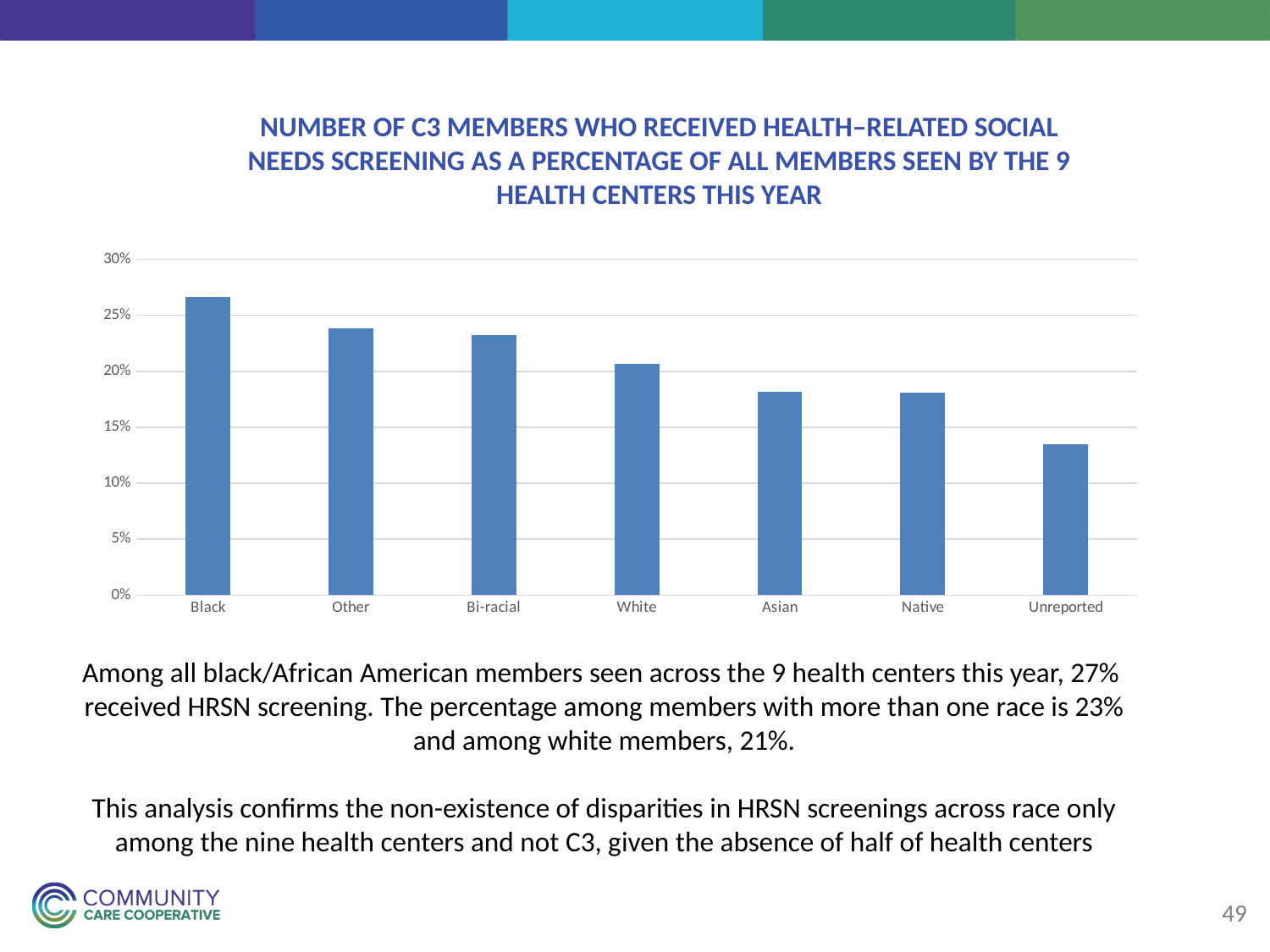
Is the value for White greater or less than 20%? greater Which category has the highest bar in the chart? Black Is the value for Black greater or less than 25%? greater How many categories are shown on the x axis of the chart? 7 Which category has the lowest bar in the chart? Unreported What is the highest value shown on the y axis of the chart? 30% Which is larger, the value for Other or the value for White? Other Do the bar values generally rise or fall from left to right across the x axis? fall What kind of chart is shown on the slide? bar chart Is the value for Unreported greater or less than 15%? less Which is larger, the value for Native or the value for Unreported? Native